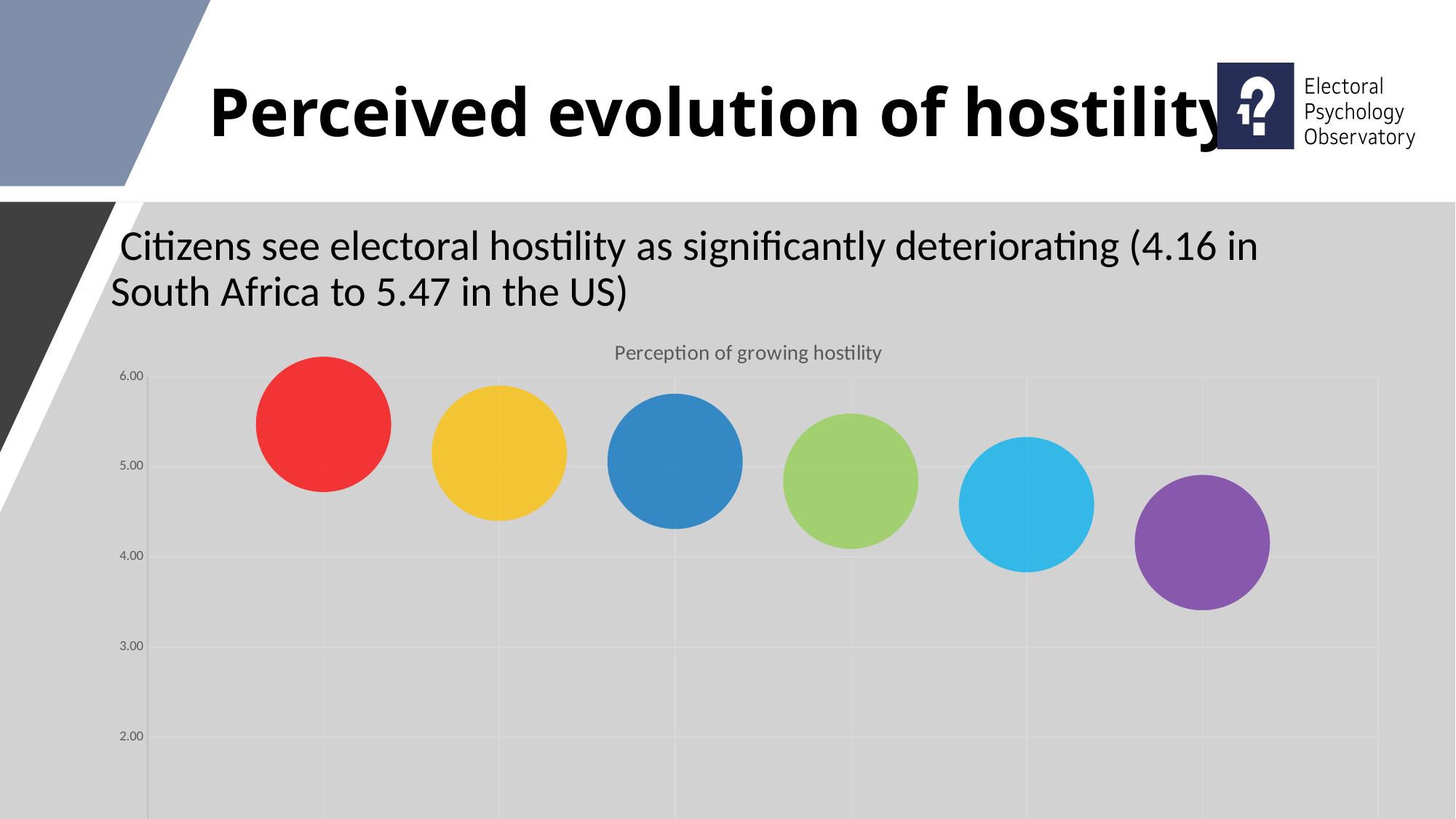
What is the title of the chart? Perception of growing hostility Do the bubble values rise or fall from left to right across the chart? Fall Is the value for the red (leftmost) bubble greater or less than 5.00? greater Which bubble sits highest on the vertical axis? The red bubble (leftmost) What kind of chart is shown on the slide? Bubble chart Which is larger, the value for the red bubble or the value for the purple bubble? The red bubble Is the value for the red (leftmost) bubble greater or less than 6.00? less Which bubble sits lowest on the vertical axis? The purple bubble (rightmost) Is the value for the light blue (fifth) bubble greater or less than 4.00? greater How many bubbles are plotted in the chart? 6 What colour is the rightmost bubble in the chart? Purple